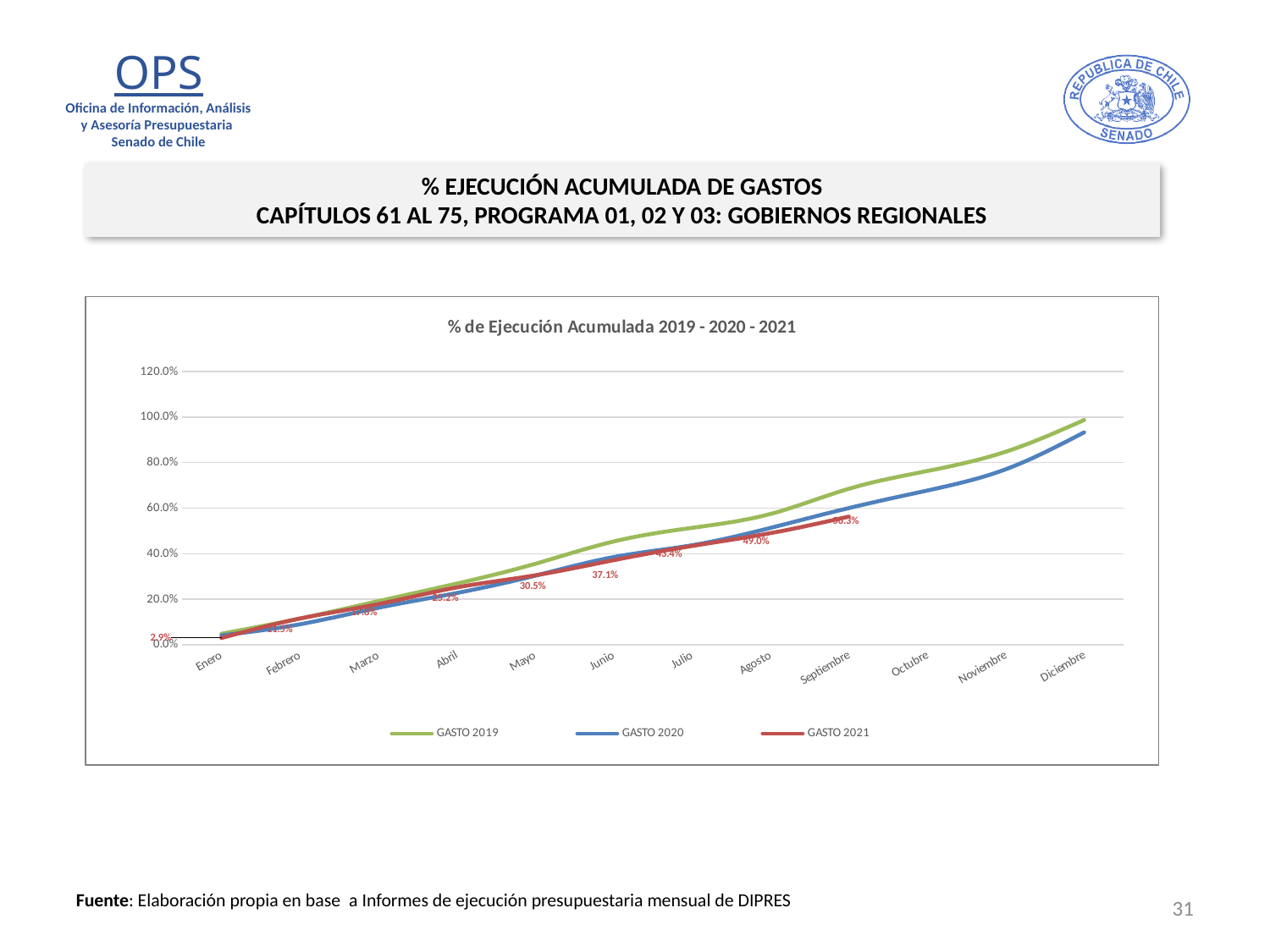
How many series does the legend list? 3 What is the value for GASTO 2021 in Enero? 2.9% What is the value for GASTO 2021 in Agosto? 49.0% Which series has the higher value in Diciembre, GASTO 2019 or GASTO 2020? GASTO 2019 Is the value for GASTO 2019 in Diciembre greater or less than 80.0%? greater What is the value for GASTO 2021 in Junio? 37.1% What type of chart is shown on the slide? Line chart What is the title of the chart? % de Ejecución Acumulada 2019 - 2020 - 2021 What is the difference between the GASTO 2021 values for Agosto and Junio? 11.9% Do the values for GASTO 2019 rise or fall from Enero to Diciembre? Rise How many months are shown along the x axis? 12 What is the value for GASTO 2021 in Mayo? 30.5%